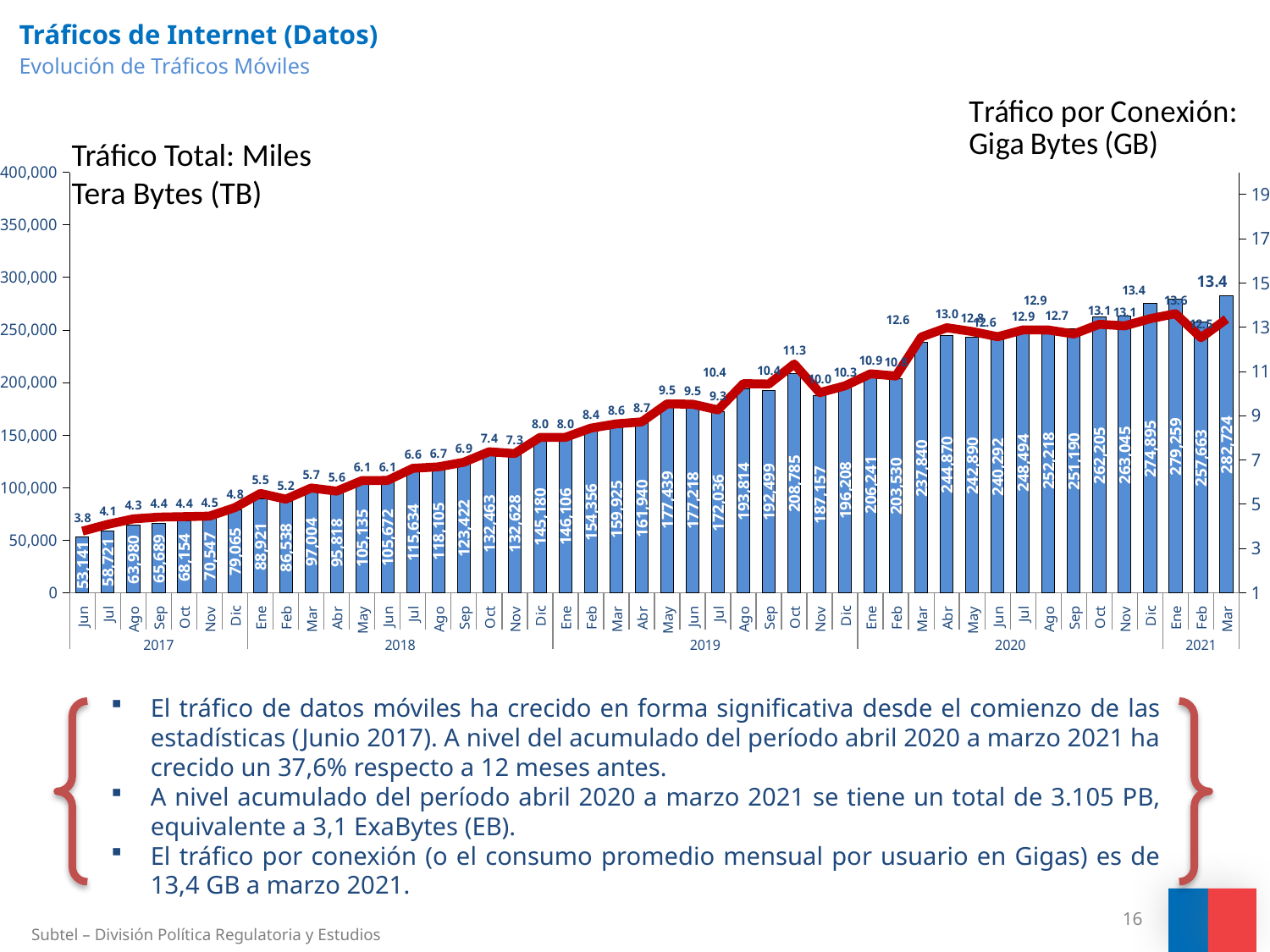
What is the difference in traffic per connection (GB) between Mar 2021 and Jun 2017? 9.6 What is the total traffic value shown for Jun 2017, the first month in the chart? 53,141 What kind of chart is used to show the total traffic values? Bar chart (with a line for traffic per connection) How many monthly bars are plotted in the chart? 46 What is the difference between the total traffic bars for Mar 2021 and Feb 2021? 25,061 Is the total traffic bar for Dic 2020 greater or less than 250,000? greater What is the total mobile traffic (Miles Tera Bytes) shown for Mar 2021? 282,724 What is the traffic per connection (GB) shown for Oct 2019? 11.3 Does the traffic per connection line generally rise or fall from Jun 2017 to Mar 2021? Rise Which month has the highest total traffic bar in the chart? Mar 2021 Which month has the lowest total traffic bar in the chart? Jun 2017 Which has a larger total traffic bar, Oct 2019 or Nov 2019? Oct 2019